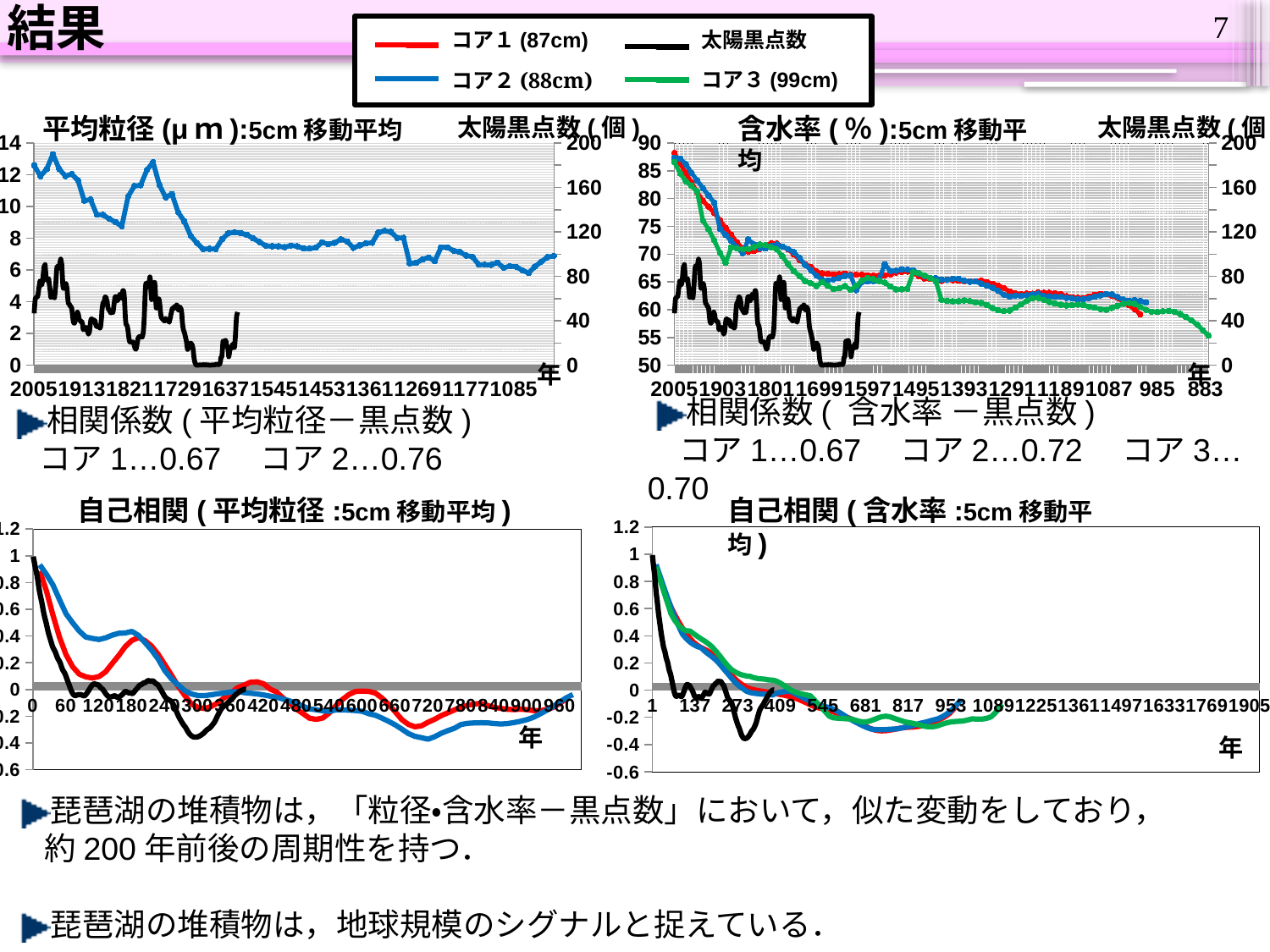
In the top legend, what core length is given for コア3? 99cm In the bottom-right chart (自己相関 含水率), how many lines are plotted? 4 In the bottom-left chart (自己相関 平均粒径), what is the value of all lines at lag 0? 1 In the top-left chart (平均粒径), what is the maximum value shown on the right-hand 太陽黒点数 axis? 200 In the top-left chart (平均粒径), is the value of the blue コア2 line at the leftmost point (2005) greater or less than 10? greater In the top-right chart (含水率), do the core lines generally rise or fall from left to right along the x axis? fall In the top-right chart (含水率), is the value of the green コア3 line at the rightmost end greater or less than 60? less In the top legend, what core length is given for コア1? 87cm In the top-left chart (平均粒径), does the blue コア2 line generally rise or fall from left to right along the x axis? fall In the top-right chart (含水率), is the value of the core lines at the leftmost point (2005) greater or less than 80? greater How many series does the legend at the top of the slide list? 4 What kind of chart is the top-left chart titled 平均粒径(μm):5cm移動平均? line chart